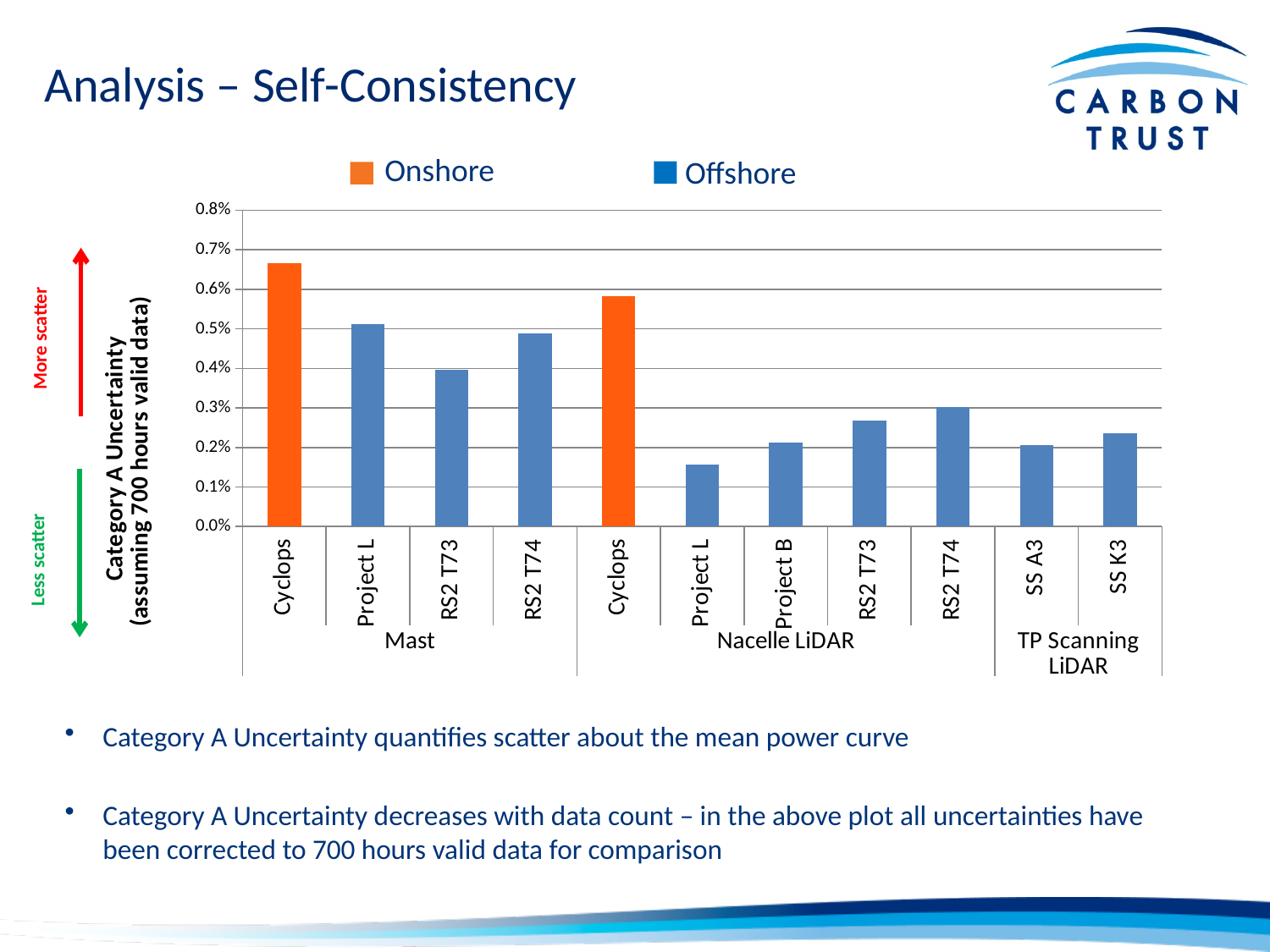
How many entries does the legend list? 2 Which is larger: SS A3 or SS K3 in the TP Scanning LiDAR group? SS K3 Is the value for RS2 T73 in the Nacelle LiDAR group greater or less than 0.3%? less Which is larger: the Cyclops value in the Mast group or the Cyclops value in the Nacelle LiDAR group? Mast How many bars are plotted in the chart? 11 What kind of chart is shown on the slide? bar chart Is the value for Cyclops in the Mast group greater or less than 0.6%? greater Which bar has the highest Category A Uncertainty? Cyclops (Mast) Is the value for Project L in the Nacelle LiDAR group greater or less than 0.2%? less Which bar has the lowest Category A Uncertainty? Project L (Nacelle LiDAR) Which legend entry is shown in orange? Onshore